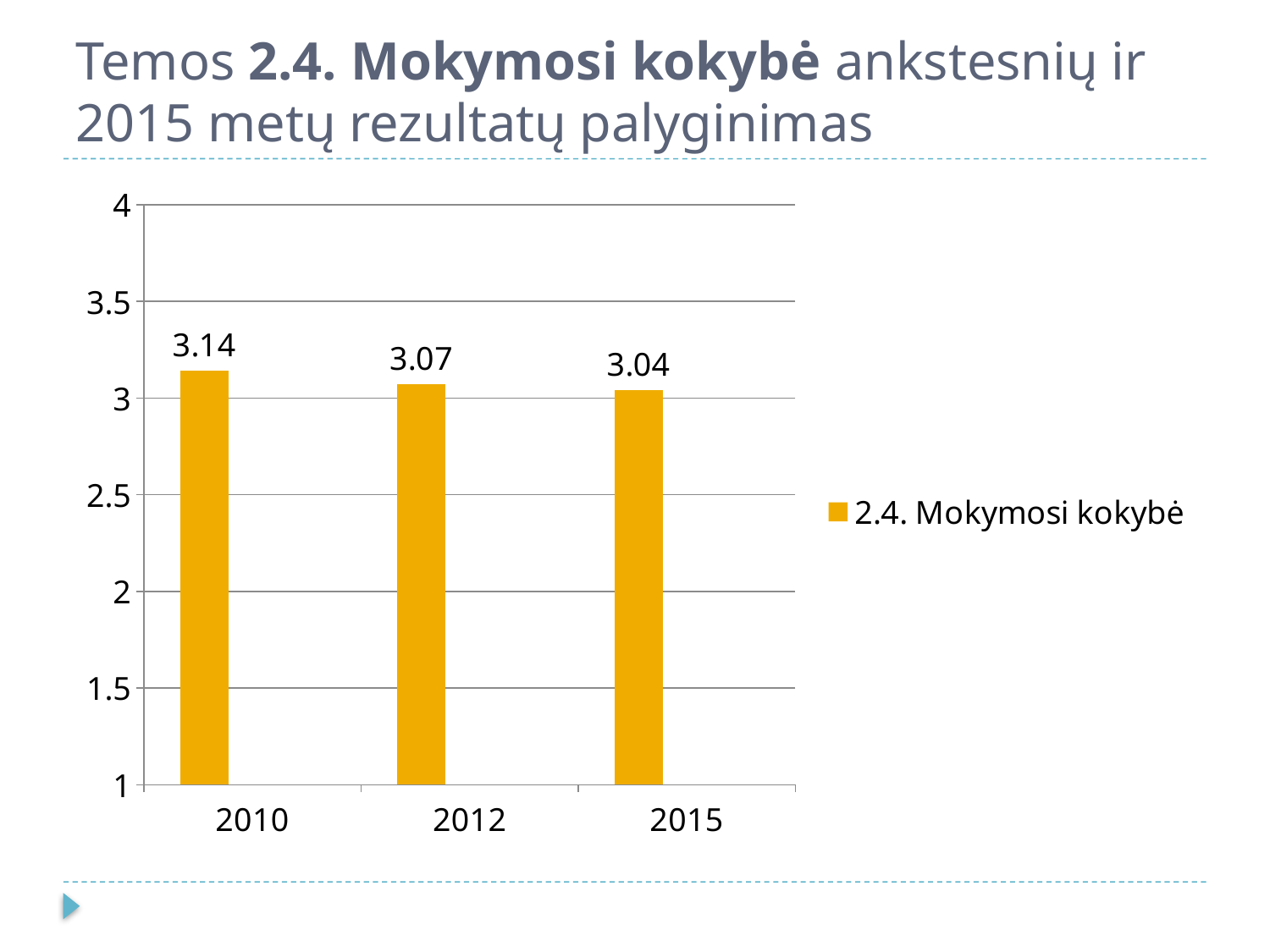
Do the values rise or fall from 2010 to 2015? fall Is the value for 2010 greater or less than 3.5? less What is the value for 2010? 3.14 What is the difference between the values for 2010 and 2015? 0.1 What is the difference between the values for 2010 and 2012? 0.07 Which year has the lowest value? 2015 How many years are shown on the x axis? 3 Which is larger, the value for 2012 or the value for 2015? 2012 What is the value for 2015? 3.04 What is the value for 2012? 3.07 Which year has the highest value? 2010 What kind of chart is shown on the slide? bar chart